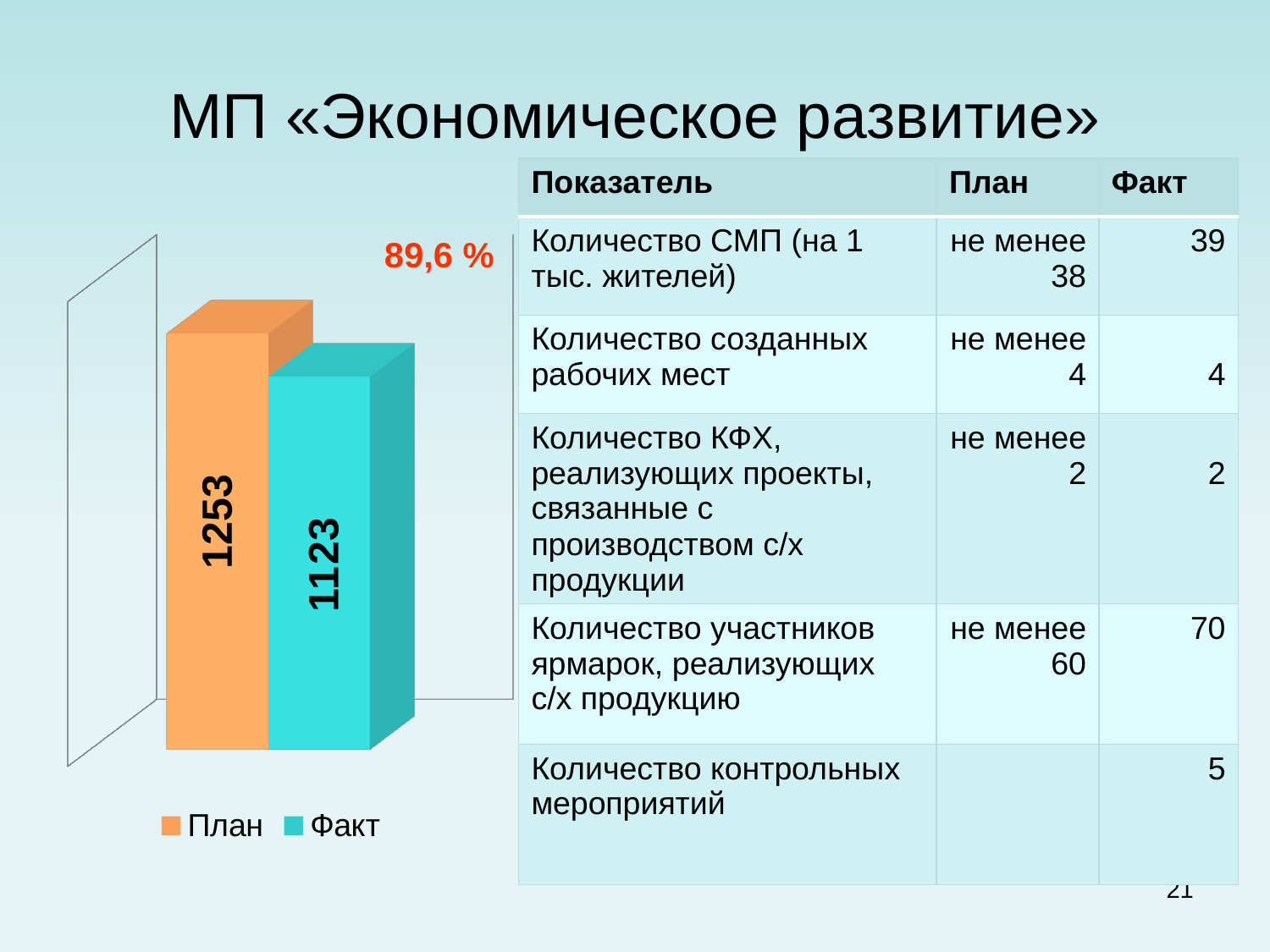
Which series has the higher bar in the chart, План or Факт? План What is the value of the План bar in the chart? 1253 Which bar in the chart is the lowest? Факт What colour is the Факт bar in the chart? teal Which bar in the chart is the highest? План What is the difference between the План and Факт values in the chart? 130 What kind of chart is shown on the slide? bar chart How many series does the chart legend list? 2 What is the value of the Факт bar in the chart? 1123 What percentage is printed above the bars in the chart? 89,6 % How many bars are plotted in the chart? 2